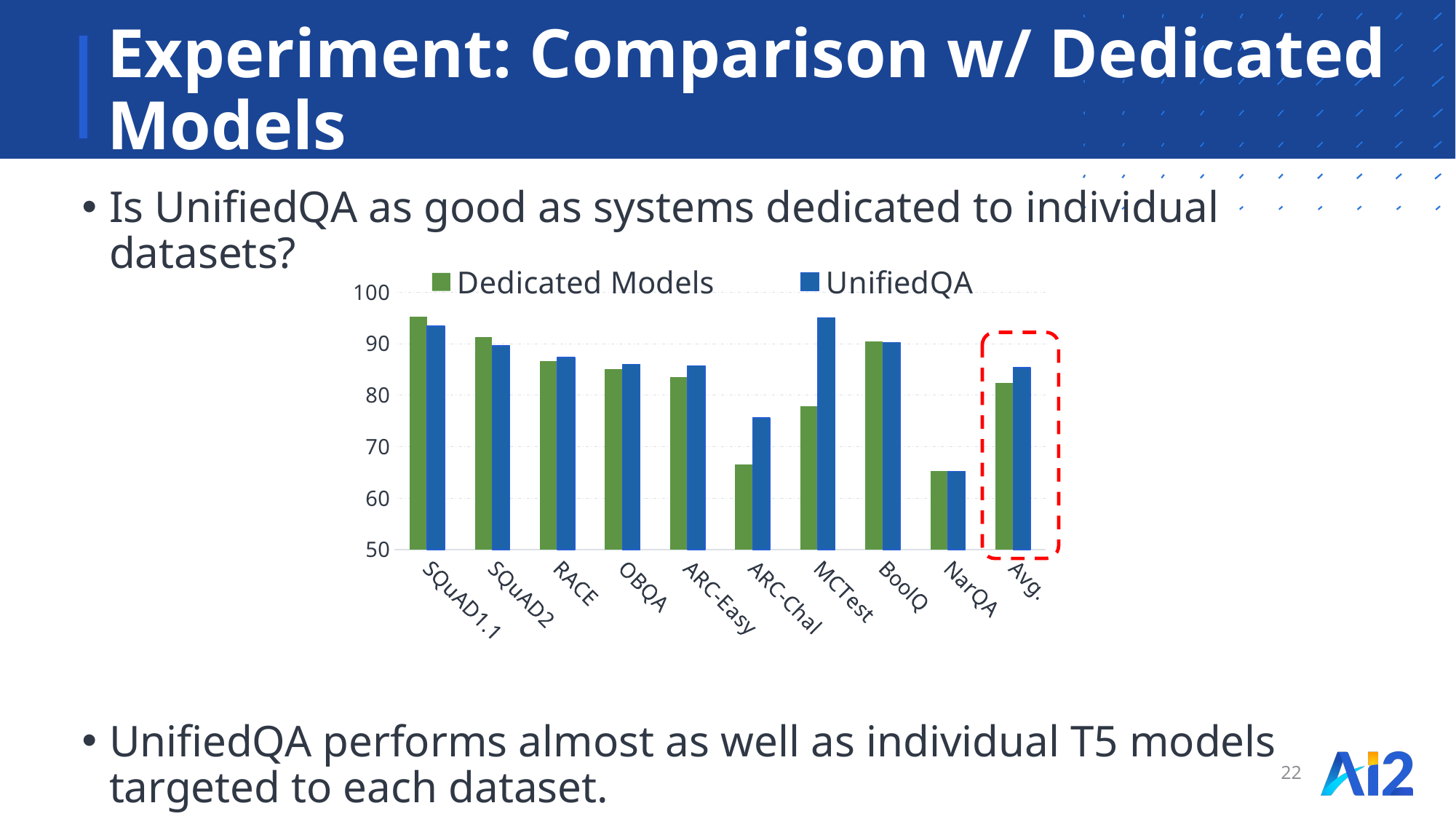
Which colour represents UnifiedQA in the chart? blue For SQuAD1.1, which series has the larger value, Dedicated Models or UnifiedQA? Dedicated Models What kind of chart is shown on the slide? bar chart How many series does the legend list? 2 For MCTest, which series has the larger value, Dedicated Models or UnifiedQA? UnifiedQA Which category has the highest value for Dedicated Models? SQuAD1.1 Is the Dedicated Models value for ARC-Chal greater or less than 70? less Which category has the lowest value for UnifiedQA? NarQA How many datasets (categories) are shown along the x axis of the chart? 10 Is the UnifiedQA value for MCTest greater or less than 90? greater Which category is highlighted with a red dashed box in the chart? Avg. Is the UnifiedQA value for Avg. greater or less than 80? greater